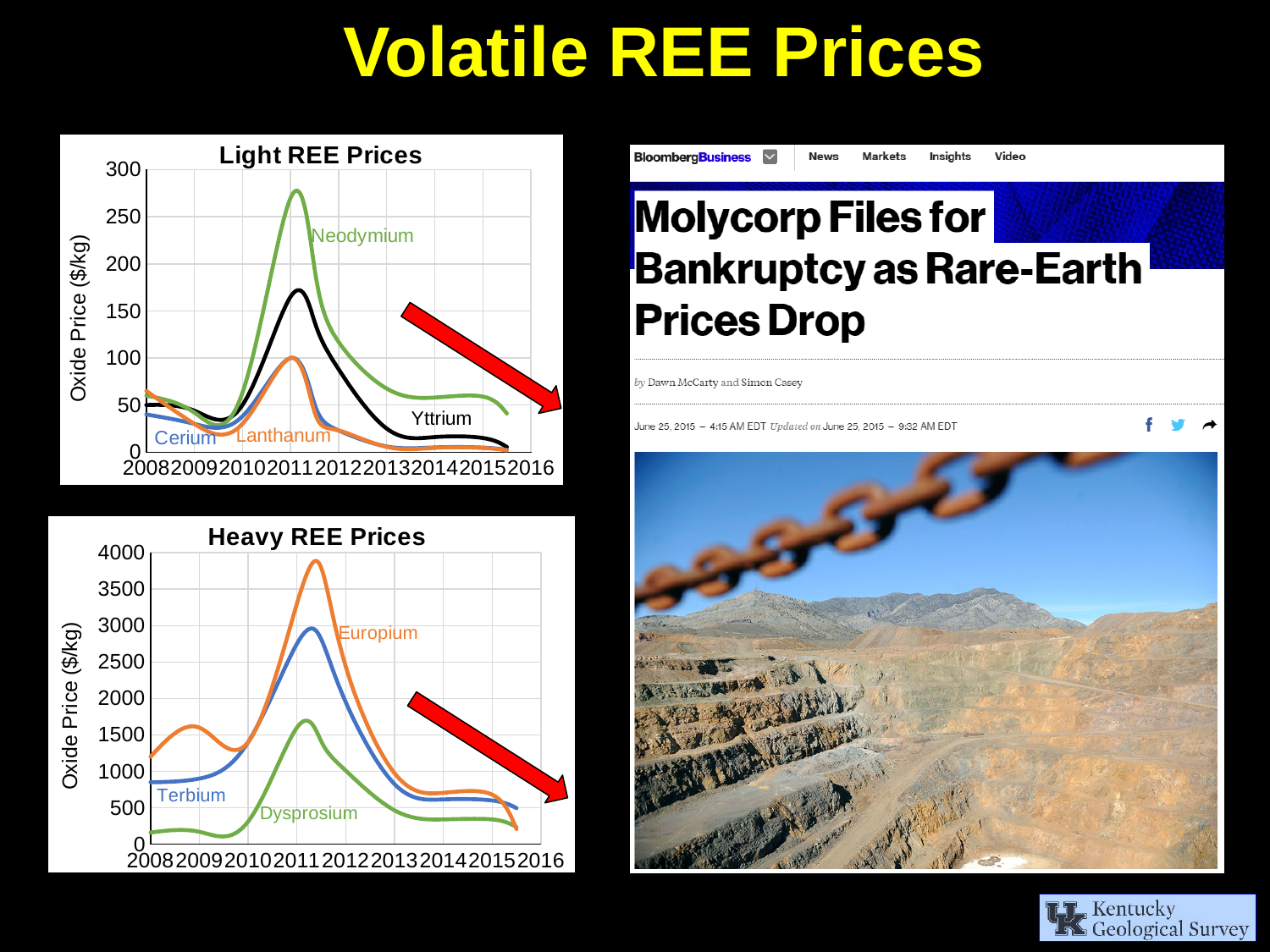
In the "Light REE Prices" chart, which peaks higher around 2011, Neodymium or Lanthanum? Neodymium In the "Heavy REE Prices" chart, is the Terbium price in 2008 greater or less than 1000? less In the "Light REE Prices" chart, is the peak price of Neodymium around 2011 greater or less than 250? greater What kind of chart is the "Light REE Prices" chart? line chart What is the y-axis label on the "Heavy REE Prices" chart? Oxide Price ($/kg) In the "Light REE Prices" chart, how many elements are plotted? 4 In the "Heavy REE Prices" chart, which element has the lowest prices across the whole period? Dysprosium In the "Light REE Prices" chart, which element reaches the highest peak price? Neodymium In the "Light REE Prices" chart, is the peak price of Yttrium around 2011 greater or less than 150? greater In the "Heavy REE Prices" chart, which element reaches the highest peak price? Europium In the "Heavy REE Prices" chart, do Europium prices rise or fall from 2011 to 2014? fall